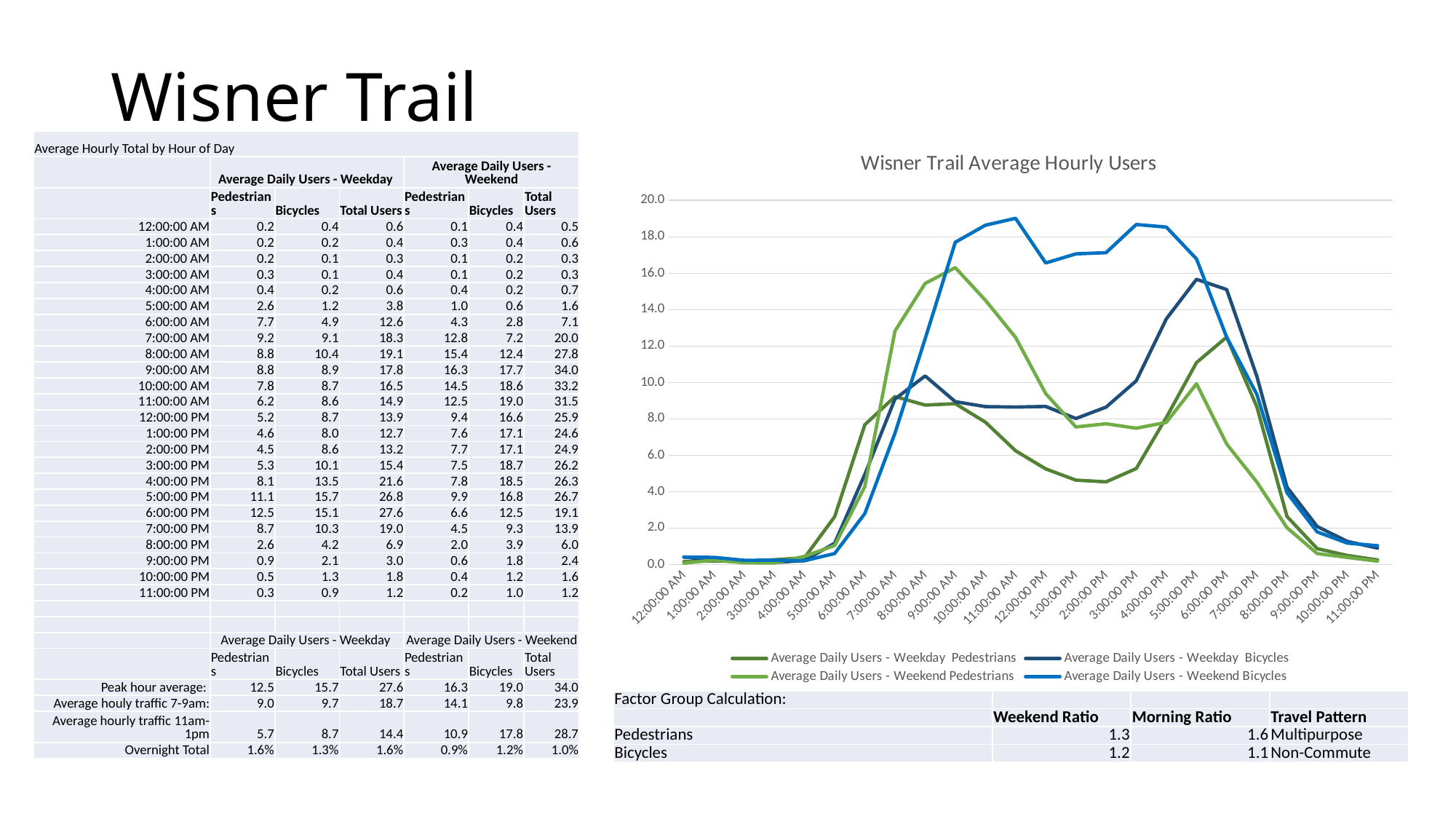
In the 'Wisner Trail Average Hourly Users' chart, what is the difference between Weekend Bicycles and Weekday Bicycles at 11:00:00 AM? 10.4 What is the value for Weekday Bicycles at 5:00:00 PM in the 'Wisner Trail Average Hourly Users' chart? 15.7 What kind of chart is 'Wisner Trail Average Hourly Users'? line chart In the 'Wisner Trail Average Hourly Users' chart, is the value for Weekend Bicycles at 11:00:00 AM greater or less than 18.0? greater In the 'Wisner Trail Average Hourly Users' chart, is the value for Weekday Pedestrians at 1:00:00 PM greater or less than 6.0? less In the 'Wisner Trail Average Hourly Users' chart, do the Weekend Bicycles values rise or fall from 6:00:00 PM to 11:00:00 PM? fall How many hours are plotted along the x axis of the 'Wisner Trail Average Hourly Users' chart? 24 At which hour does the Weekday Pedestrians series peak in the 'Wisner Trail Average Hourly Users' chart? 6:00:00 PM What is the value for Weekend Pedestrians at 9:00:00 AM in the 'Wisner Trail Average Hourly Users' chart? 16.3 In the 'Wisner Trail Average Hourly Users' chart, at 9:00:00 AM which is larger: Weekend Pedestrians or Weekday Pedestrians? Weekend Pedestrians How many series does the legend of the 'Wisner Trail Average Hourly Users' chart list? 4 In the 'Wisner Trail Average Hourly Users' chart, which series reaches the highest value? Average Daily Users - Weekend Bicycles